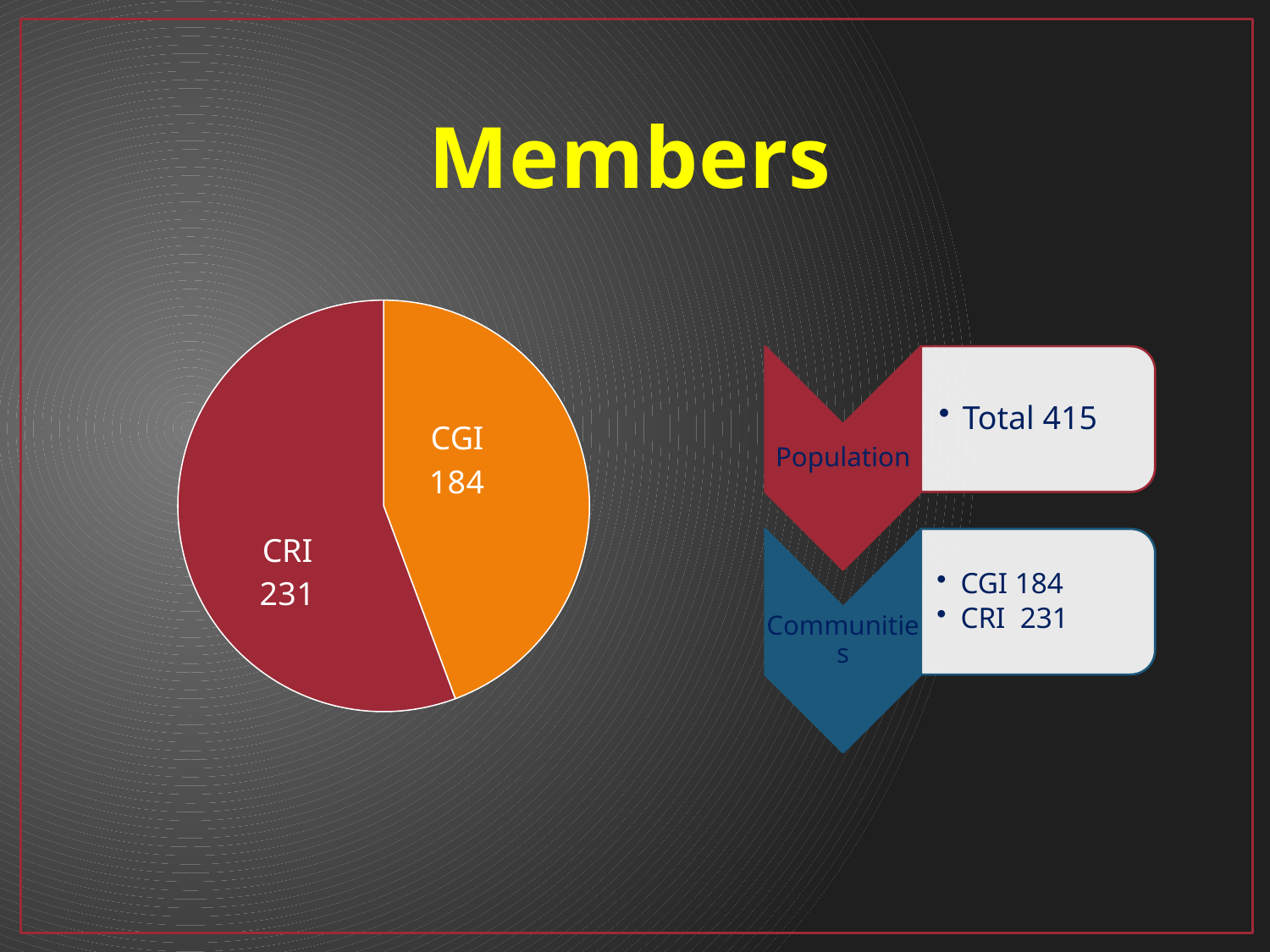
What is the difference between the CRI and CGI values in the pie chart? 47 What colour is the CGI slice in the pie chart? orange Which slice of the pie chart is the smallest? CGI What is the title of the slide containing the pie chart? Members What is the value for CRI in the pie chart? 231 What share of the pie chart does CRI represent? 55.7% How many slices does the pie chart have? 2 What is the value for CGI in the pie chart? 184 What type of chart is shown on the slide? pie chart Which is larger in the pie chart, CGI or CRI? CRI What is the total of the two slices in the pie chart? 415 Which slice of the pie chart is the largest? CRI